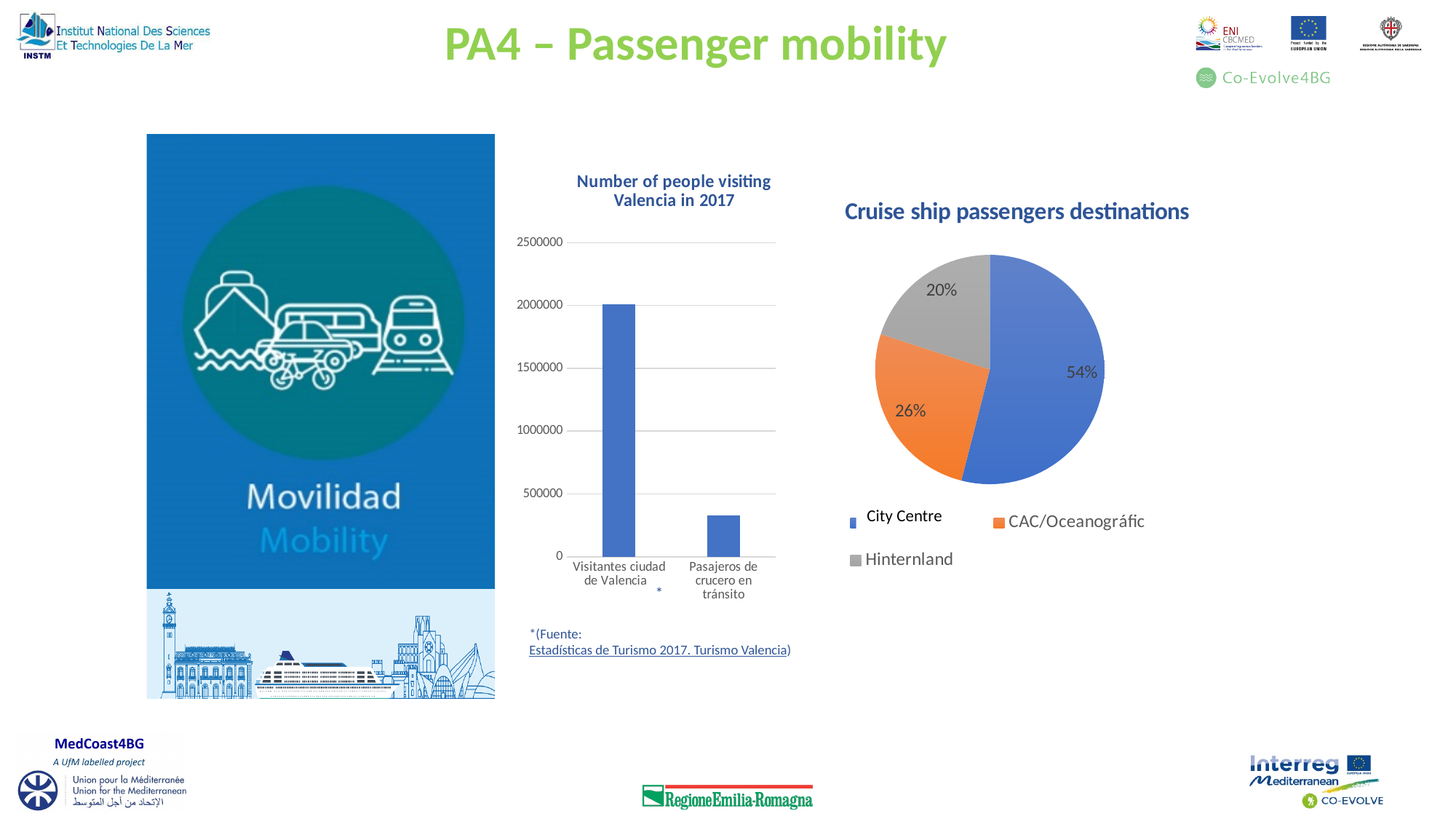
In the 'Cruise ship passengers destinations' pie chart, what share goes to CAC/Oceanográfic? 26% In the 'Cruise ship passengers destinations' pie chart, what is the difference in percentage points between City Centre and Hinterland? 34 In the 'Cruise ship passengers destinations' pie chart, which destination has the largest share? City Centre In the 'Cruise ship passengers destinations' pie chart, what share goes to Hinterland? 20% In the 'Number of people visiting Valencia in 2017' chart, is the value for 'Visitantes ciudad de Valencia' greater or less than 1500000? greater What kind of chart is 'Number of people visiting Valencia in 2017'? Bar chart In the 'Cruise ship passengers destinations' pie chart, which destination has the smallest share? Hinterland In the 'Cruise ship passengers destinations' pie chart, how many destinations does the legend list? 3 In the 'Cruise ship passengers destinations' pie chart, what share goes to City Centre? 54% In the 'Number of people visiting Valencia in 2017' chart, is the value for 'Pasajeros de crucero en tránsito' greater or less than 500000? less In the 'Number of people visiting Valencia in 2017' chart, how many categories are shown? 2 What kind of chart is 'Cruise ship passengers destinations'? Pie chart